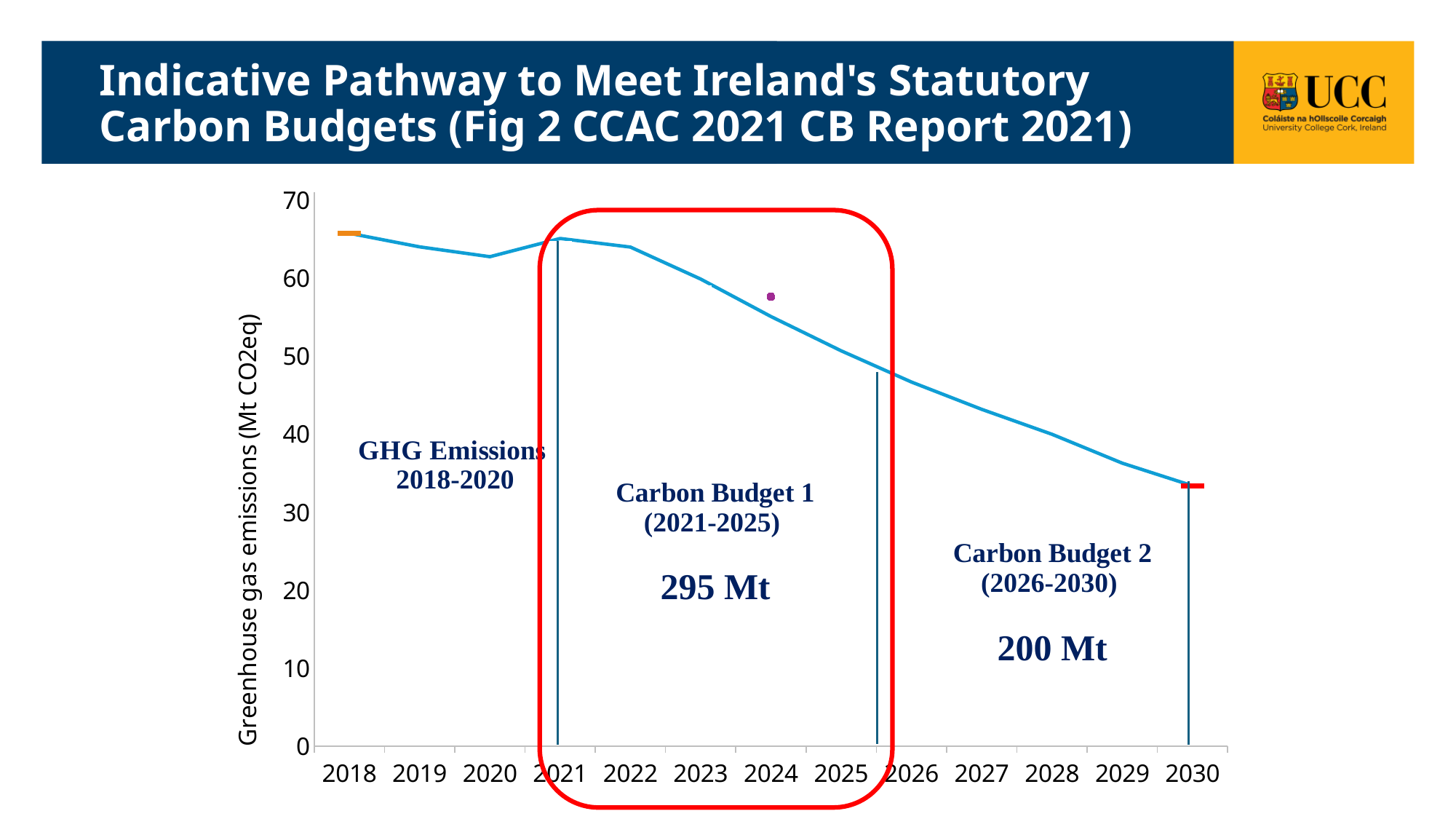
What kind of chart is shown on the slide? line chart Is the value for 2030 greater or less than 40? less Is the value for 2023 greater or less than 50? greater Do the emissions rise or fall from 2021 to 2030? fall What is the carbon budget amount shown for Carbon Budget 1 (2021-2025)? 295 Mt Which year has higher emissions, 2022 or 2026? 2022 What is the carbon budget amount shown for Carbon Budget 2 (2026-2030)? 200 Mt What is the label on the y axis? Greenhouse gas emissions (Mt CO2eq) Which year has the lowest greenhouse gas emissions on the chart? 2030 Is the value for 2029 greater or less than 40? less How many years are shown on the x axis? 13